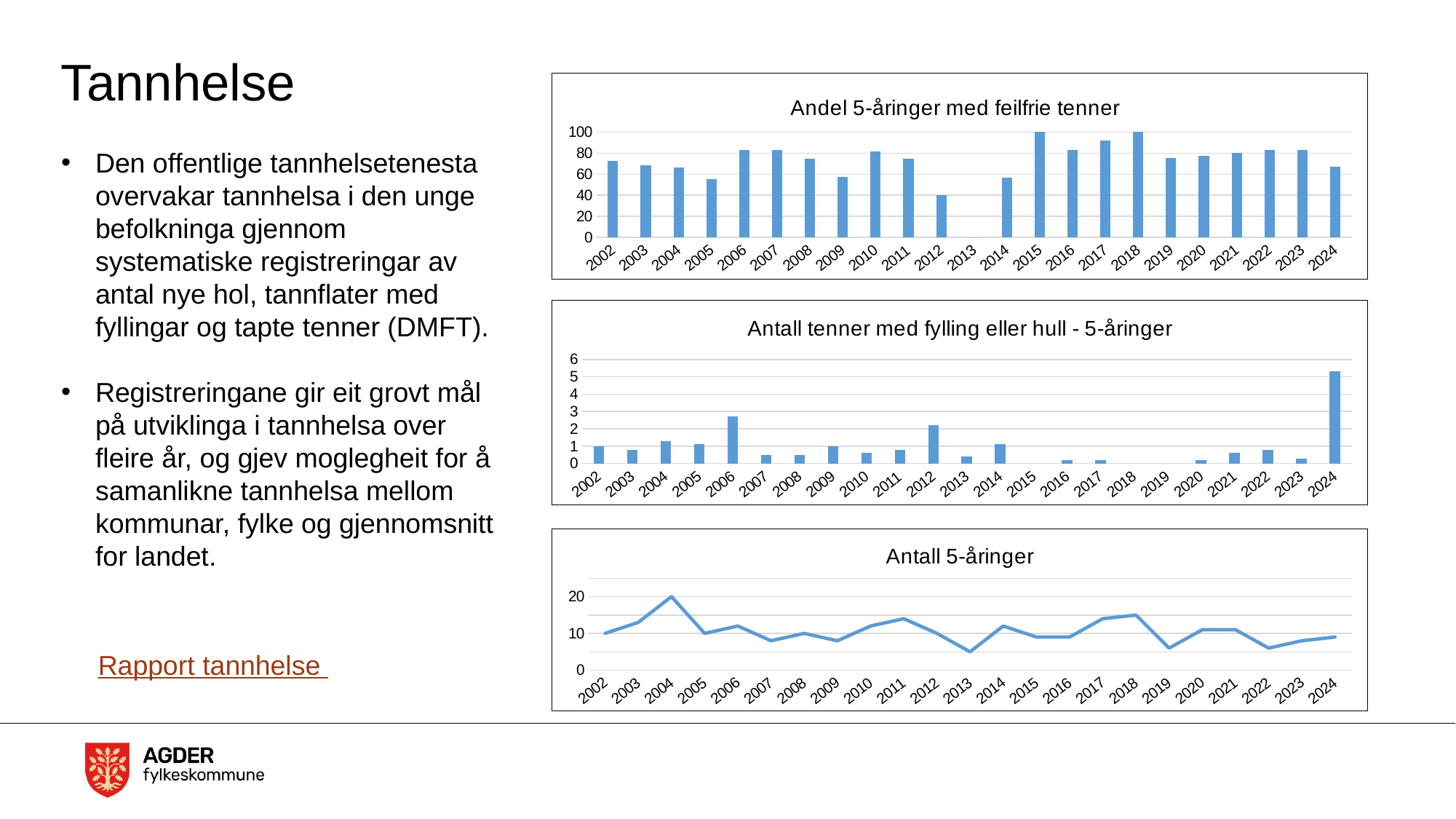
In the middle chart, "Antall tenner med fylling eller hull - 5-åringer", which year has the highest value? 2024 In the bottom chart, "Antall 5-åringer", what is the value for 2004? 20 What kind of chart is the top chart, "Andel 5-åringer med feilfrie tenner"? bar chart In the top chart, "Andel 5-åringer med feilfrie tenner", is the value for 2012 greater or less than 60? less In the middle chart, "Antall tenner med fylling eller hull - 5-åringer", is the value for 2006 greater or less than 2? greater In the top chart, "Andel 5-åringer med feilfrie tenner", is the value for 2017 greater or less than 80? greater In the top chart, "Andel 5-åringer med feilfrie tenner", which year has the larger value, 2015 or 2012? 2015 In the bottom chart, "Antall 5-åringer", which year has the highest value? 2004 In the bottom chart, "Antall 5-åringer", which year has the lowest value? 2013 In the middle chart, "Antall tenner med fylling eller hull - 5-åringer", which year has the larger value, 2012 or 2007? 2012 What kind of chart is the bottom chart, "Antall 5-åringer"? line chart How many years are shown on the x axis of the bottom chart, "Antall 5-åringer"? 23